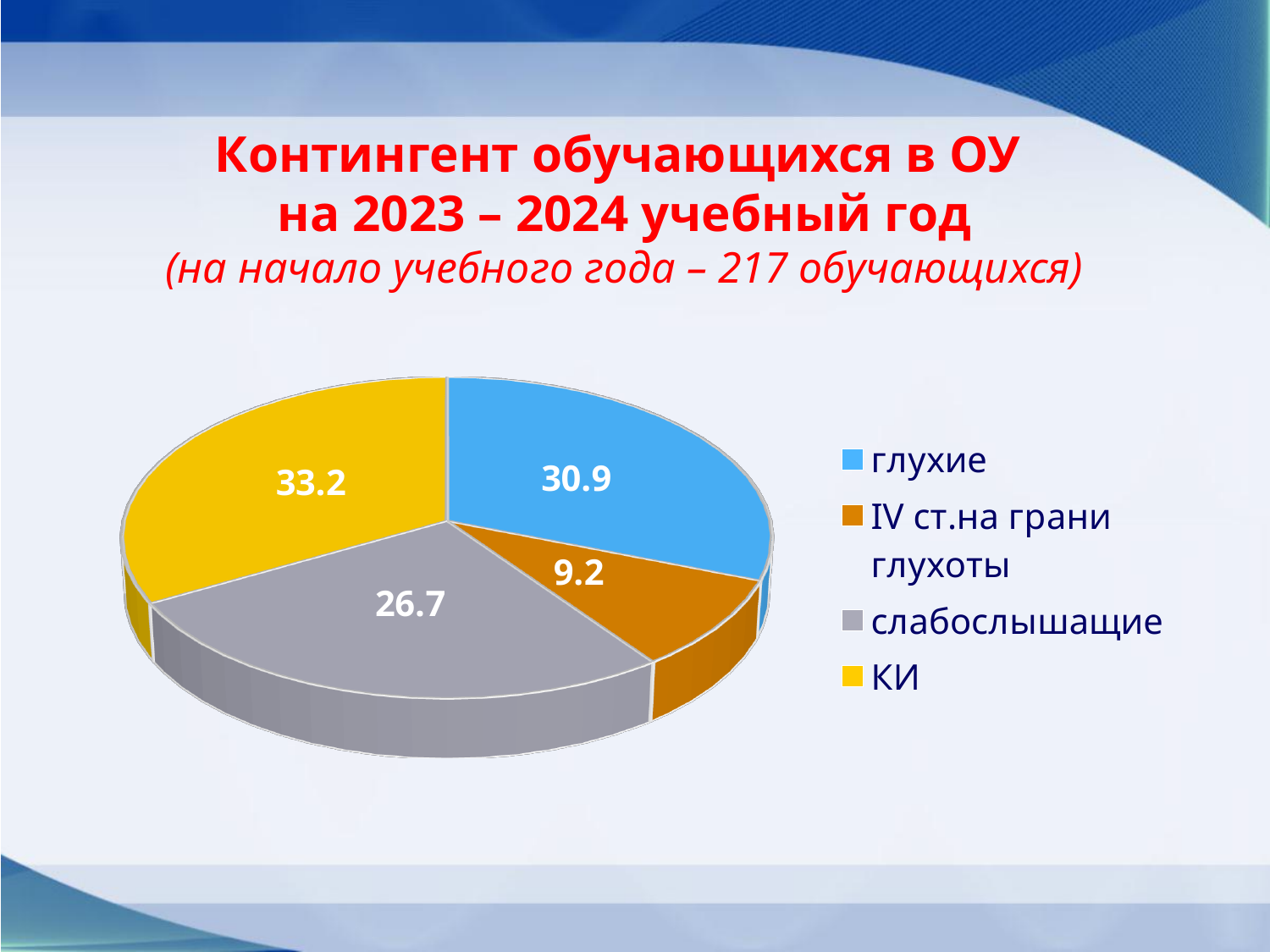
Which is larger, the value for "глухие" or the value for "слабослышащие"? глухие What is the value shown for the "слабослышащие" slice? 26.7 What colour is the "слабослышащие" slice? gray What is the value shown for the "глухие" slice? 30.9 How many slices does the pie chart have? 4 What kind of chart is shown on the slide? pie chart What is the value shown for the "КИ" slice? 33.2 Which category has the largest slice of the pie? КИ What is the difference between the values for "КИ" and "глухие"? 2.3 Which category has the smallest slice of the pie? IV ст.на грани глухоты What is the difference between the values for "слабослышащие" and "IV ст.на грани глухоты"? 17.5 What is the value shown for the "IV ст.на грани глухоты" slice? 9.2